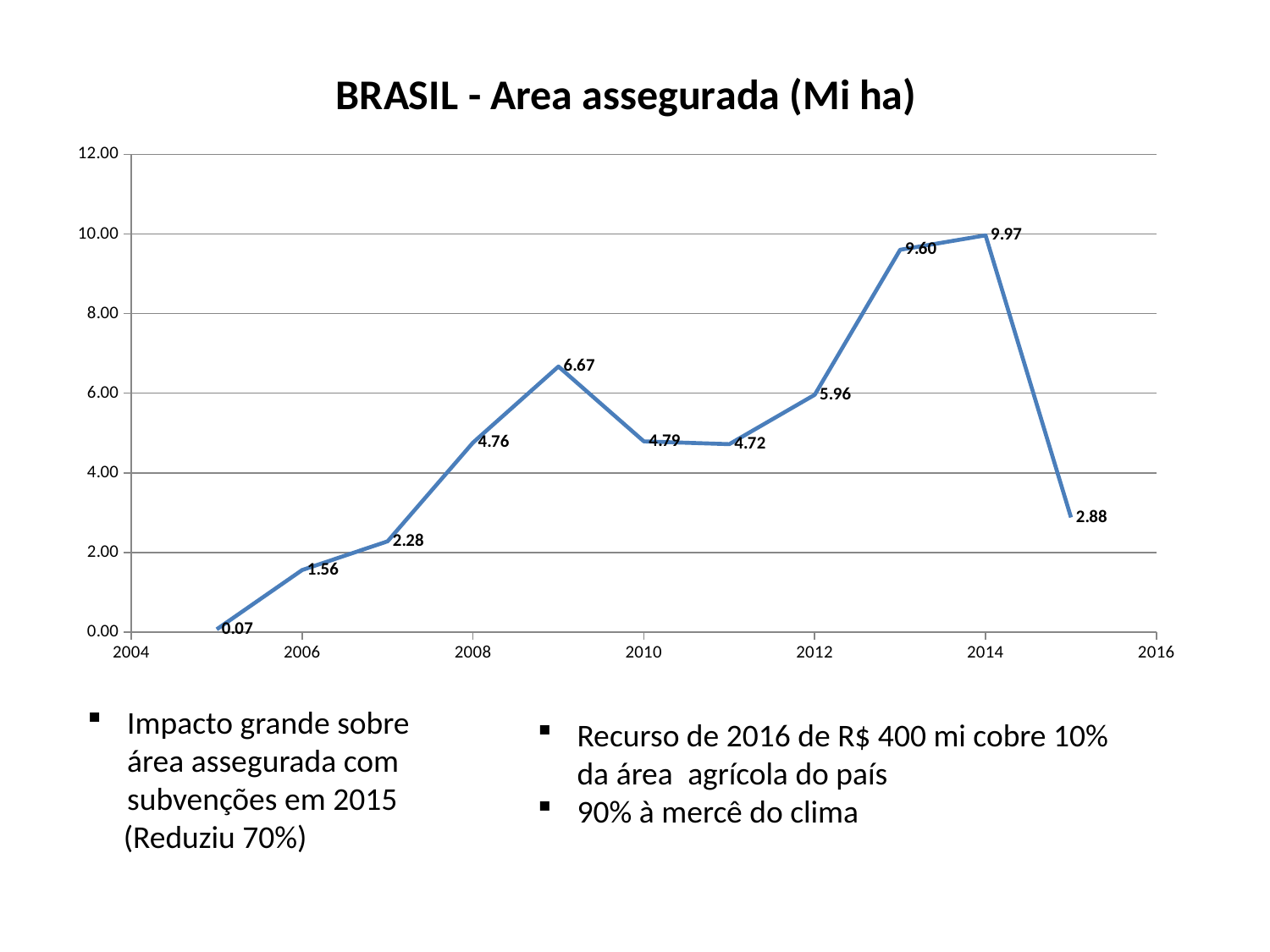
What is the value plotted for 2010? 4.79 In which year does the line reach its highest value? 2014 How many data points are labelled on the line? 11 Which year has the larger value, 2012 or 2013? 2013 Does the line rise or fall between 2014 and 2015? fall What type of chart is shown on the slide? line chart What is the value plotted for 2008? 4.76 By how much does the value drop from 2014 (9.97) to 2015 (2.88)? 7.09 What is the value plotted for 2014? 9.97 What is the lowest value labelled on the line? 0.07 What is the value plotted for 2012? 5.96 What is the title of the chart? BRASIL - Area assegurada (Mi ha)